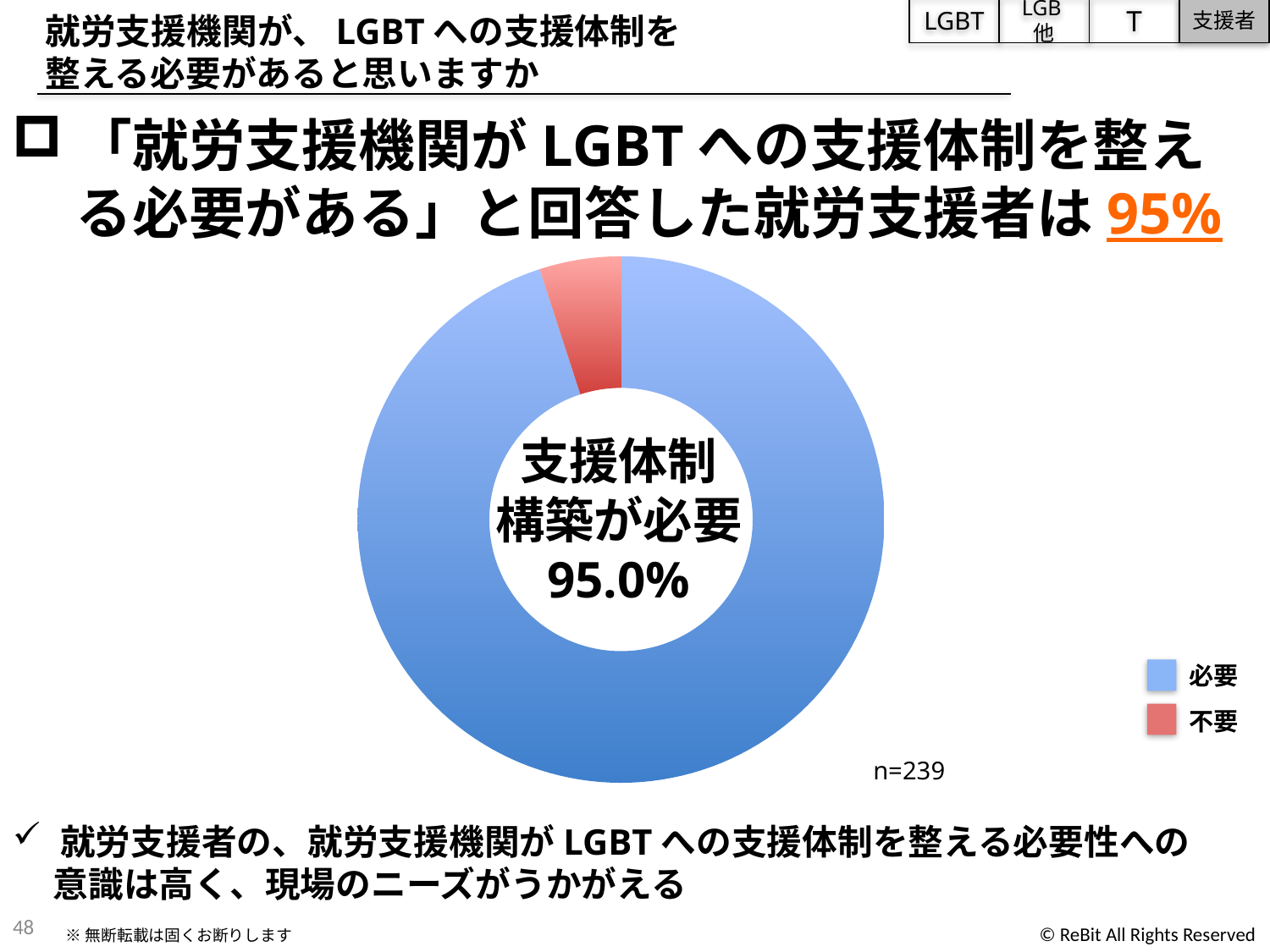
Which category has the smallest share of the pie chart? 不要 Which category has the largest share of the pie chart? 必要 What colour represents 不要 in the pie chart? Red Which is larger in the pie chart, 必要 or 不要? 必要 What kind of chart is shown on the slide? Pie chart (donut) What percentage is shown for 必要 (support system construction needed) in the chart? 95.0% How many entries does the legend list? 2 What is the sample size (n) shown next to the chart? n=239 How many categories does the pie chart show? 2 What text is written in the centre of the donut chart? 支援体制構築が必要 95.0%